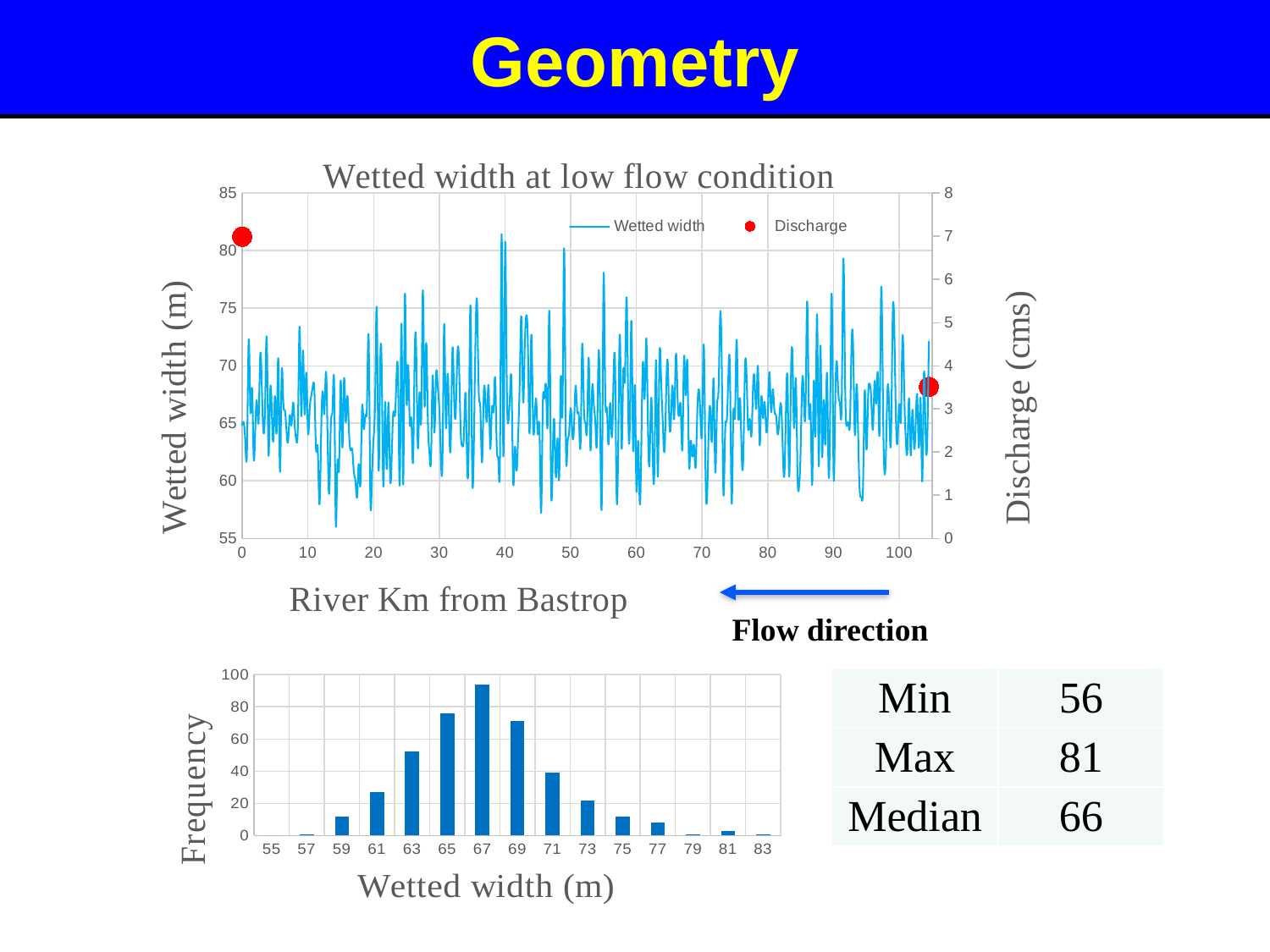
In the top chart, what kind of chart is used to plot the Wetted width series? line chart In the bottom chart, do the frequencies rise or fall from wetted width 67 to wetted width 77? fall In the top chart, is the Discharge value at the downstream end (around river km 105) greater or less than 4 cms? less What is the title of the top chart? Wetted width at low flow condition In the top chart, how many series does the legend list? 2 In the bottom chart, how many wetted width categories are shown on the x axis? 15 What kind of chart is the bottom chart showing Frequency against Wetted width? bar chart In the bottom chart, is the frequency for wetted width 61 greater or less than 40? less In the bottom chart, which has the higher frequency, wetted width 63 or wetted width 71? 63 In the bottom chart, which wetted width category has the highest frequency? 67 In the bottom chart, is the frequency for wetted width 67 greater or less than 80? greater